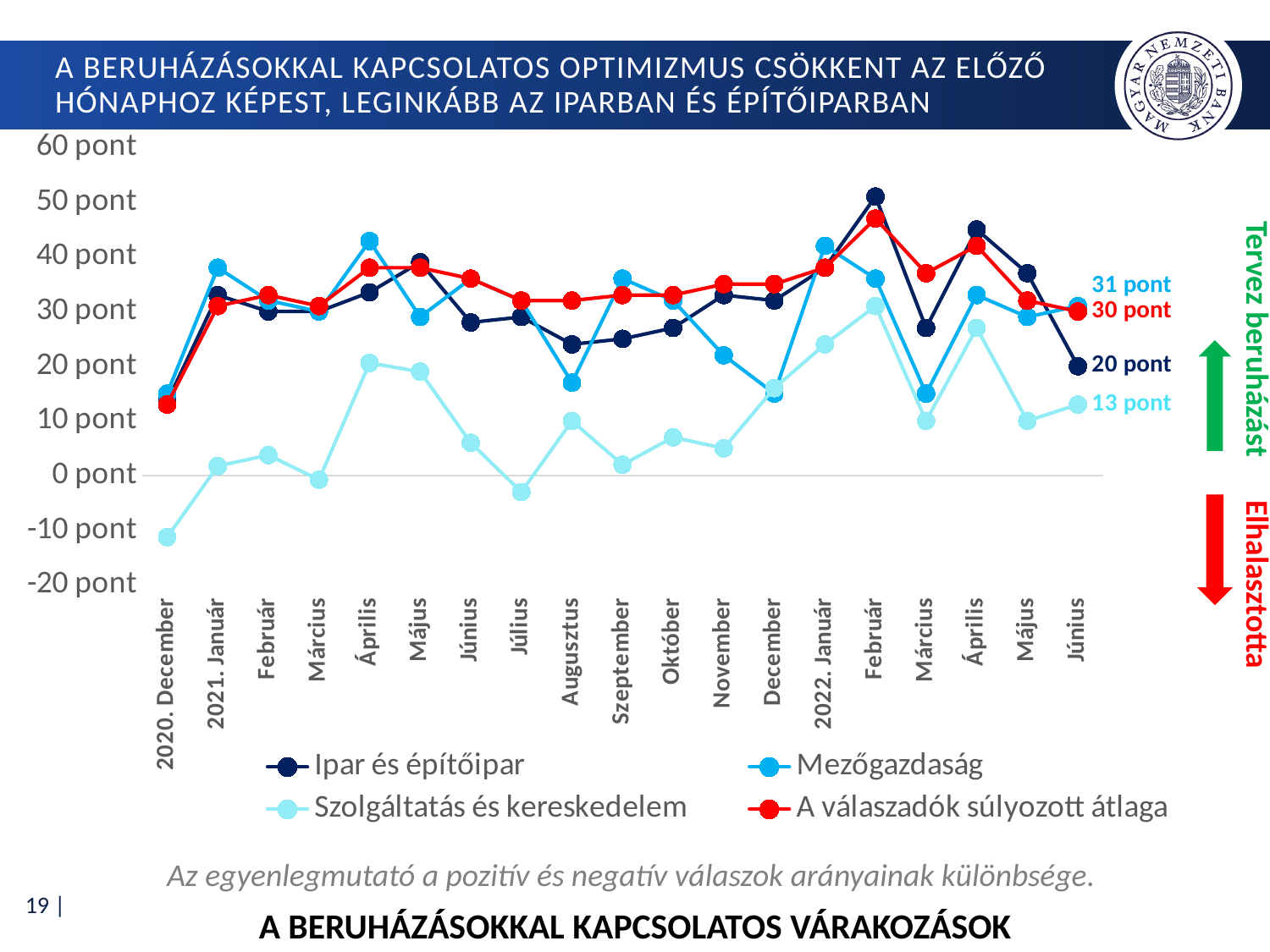
Is the value for Szolgáltatás és kereskedelem in 2020 December greater or less than 0 pont? less How many series does the legend list? 4 What is the value for Szolgáltatás és kereskedelem in 2022 Június? 13 pont What is the value for Mezőgazdaság in 2022 Június? 31 pont How many months are shown on the x axis? 19 Which is larger in 2022 Június: Ipar és építőipar or Szolgáltatás és kereskedelem? Ipar és építőipar What is the difference between the Mezőgazdaság and Szolgáltatás és kereskedelem values in 2022 Június? 18 pont Which series has the highest value in 2022 Február? Ipar és építőipar What is the value for Ipar és építőipar in 2022 Június? 20 pont Which series has the lowest value in 2020 December? Szolgáltatás és kereskedelem What kind of chart is shown on the slide? Line chart What is the value for A válaszadók súlyozott átlaga in 2022 Június? 30 pont